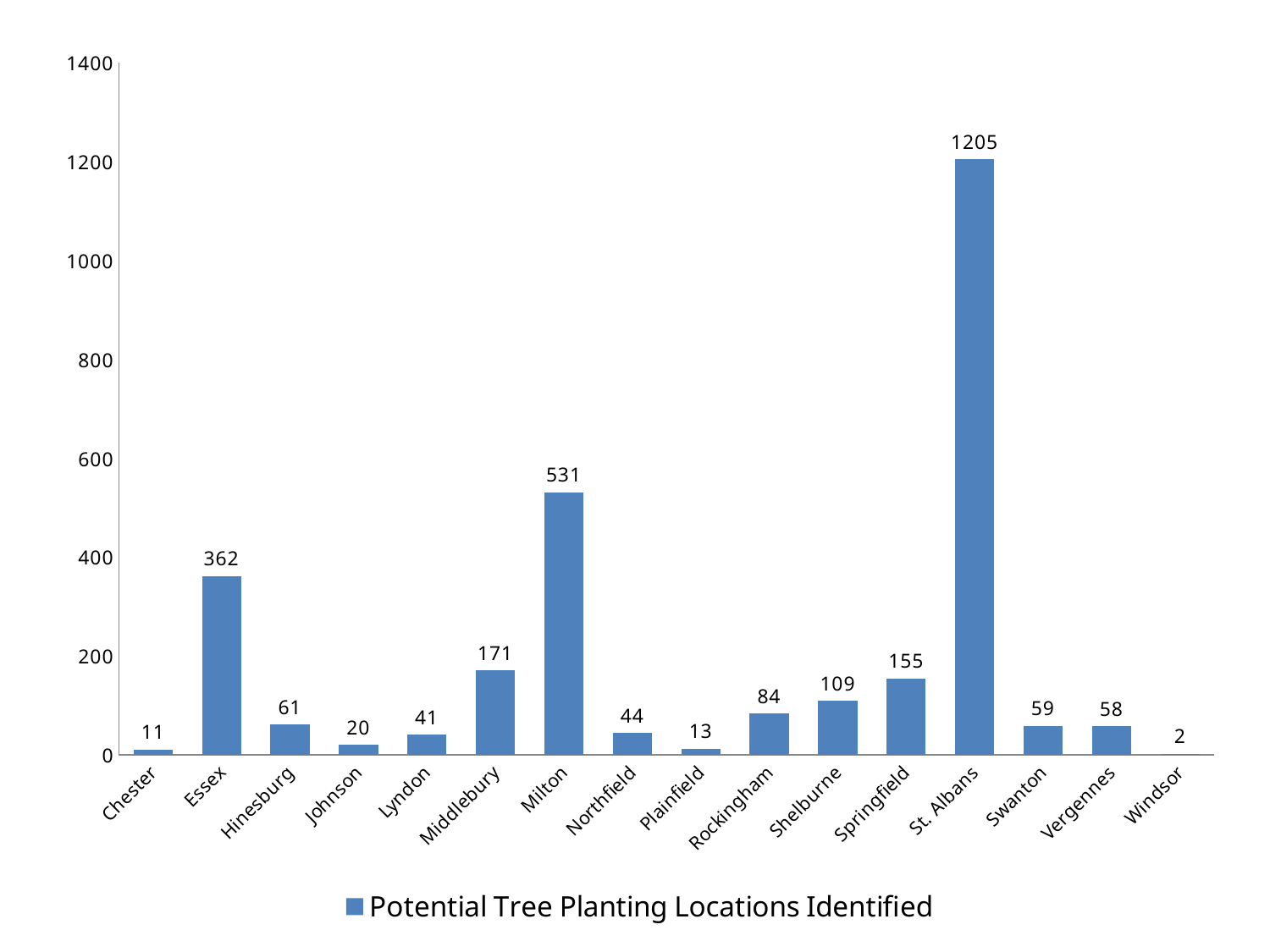
What kind of chart is shown on the slide? bar chart What is the value for Windsor? 2 Which town has the highest number of potential tree planting locations identified? St. Albans What is the value for Middlebury? 171 What is the value for St. Albans? 1205 Which is larger, the value for Springfield or the value for Shelburne? Springfield Which town has the lowest number of potential tree planting locations identified? Windsor How many series does the legend list? 1 What is the difference between the values for Milton and Essex? 169 Is the value for Essex greater or less than 400? less What is the legend entry for the series shown? Potential Tree Planting Locations Identified How many towns are shown on the x axis? 16